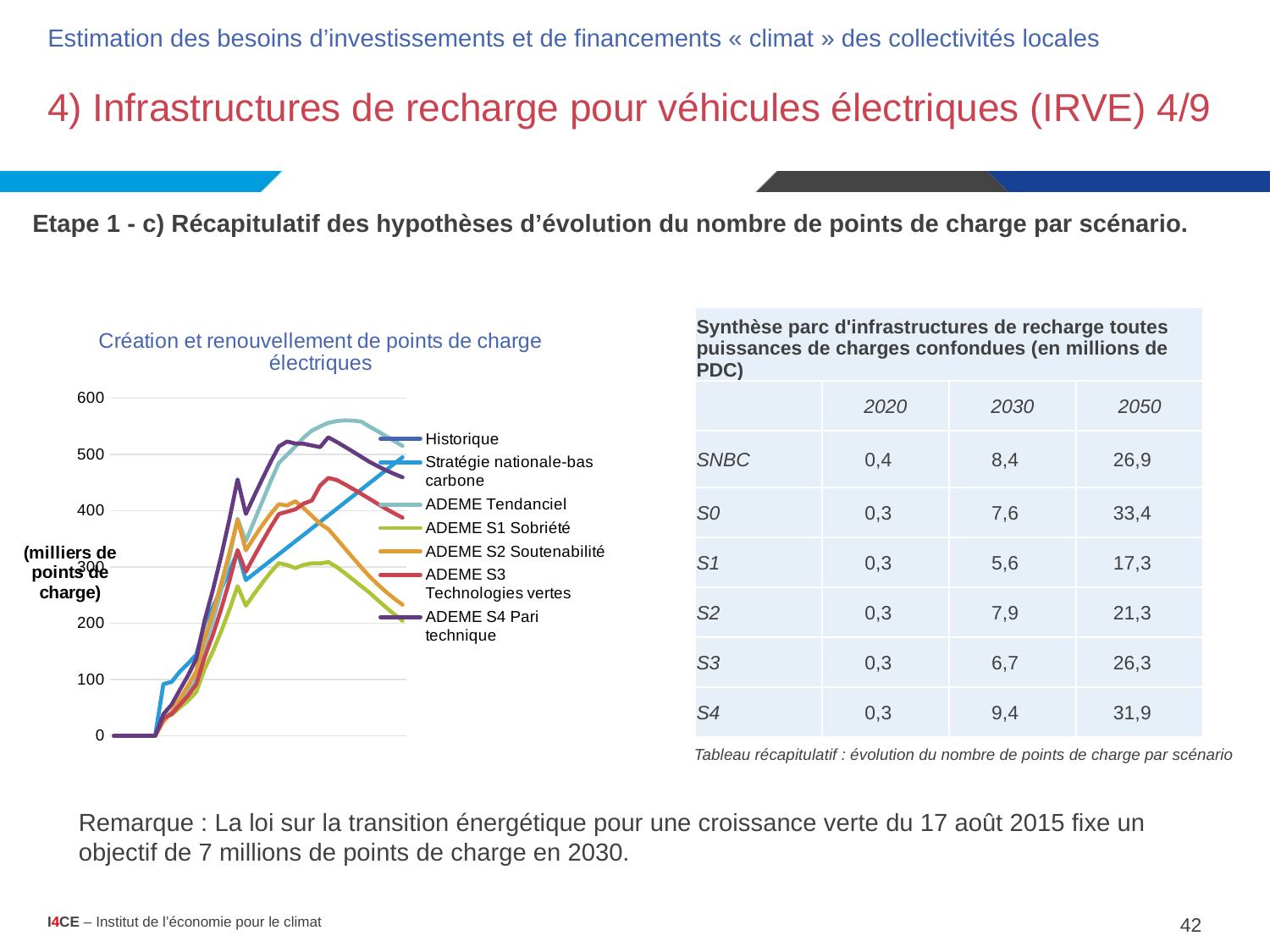
Does the Stratégie nationale-bas carbone series generally rise or fall along the x axis? rise What unit is given for the vertical axis of the chart? milliers de points de charge Is the final value of the ADEME S2 Soutenabilité series greater or less than 300? less How many series does the legend of the chart list? 7 At the right end of the chart, which series is higher: Stratégie nationale-bas carbone or ADEME S1 Sobriété? Stratégie nationale-bas carbone Is the peak value of the ADEME Tendanciel series greater or less than 500? greater What is the highest value shown on the vertical axis of the chart? 600 What is the title of the chart? Création et renouvellement de points de charge électriques Is the peak value of the ADEME S3 Technologies vertes series greater or less than 400? greater What kind of chart is shown on the slide? line chart